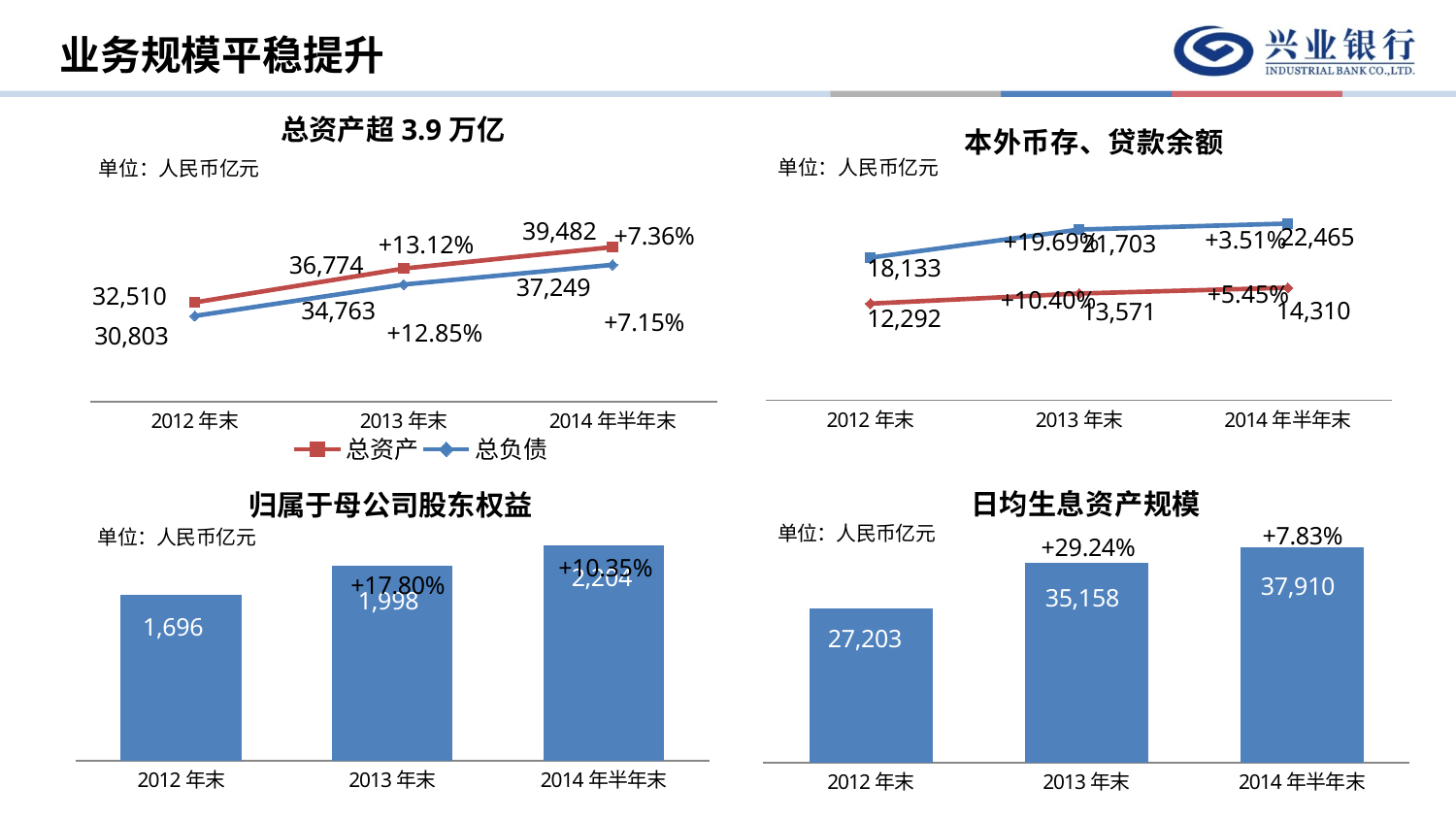
In the chart titled 日均生息资产规模, do the values rise or fall from 2012 年末 to 2014 年半年末? rise What kind of chart is the chart titled 归属于母公司股东权益? bar chart In the chart titled 本外币存、贷款余额, what is the value of the upper (blue) line at 2013 年末? 21,703 In the chart titled 日均生息资产规模, what is the difference between the 2013 年末 and 2012 年末 values? 7,955 How many series does the legend of the chart titled 总资产超 3.9 万亿 list? 2 In the chart titled 总资产超 3.9 万亿, what is the value of 总负债 at 2012 年末? 30,803 In the chart titled 总资产超 3.9 万亿, what is the difference between 总资产 and 总负债 at 2013 年末? 2,011 In the chart titled 本外币存、贷款余额, what growth percentage is shown for the upper (blue) line between 2012 年末 and 2013 年末? +19.69% In the chart titled 总资产超 3.9 万亿, what is the value of 总资产 at 2014 年半年末? 39,482 In the chart titled 归属于母公司股东权益, which period has the highest value? 2014 年半年末 In the chart titled 归属于母公司股东权益, what is the value for 2012 年末? 1,696 In the chart titled 本外币存、贷款余额, what is the value of the lower (red) line at 2014 年半年末? 14,310